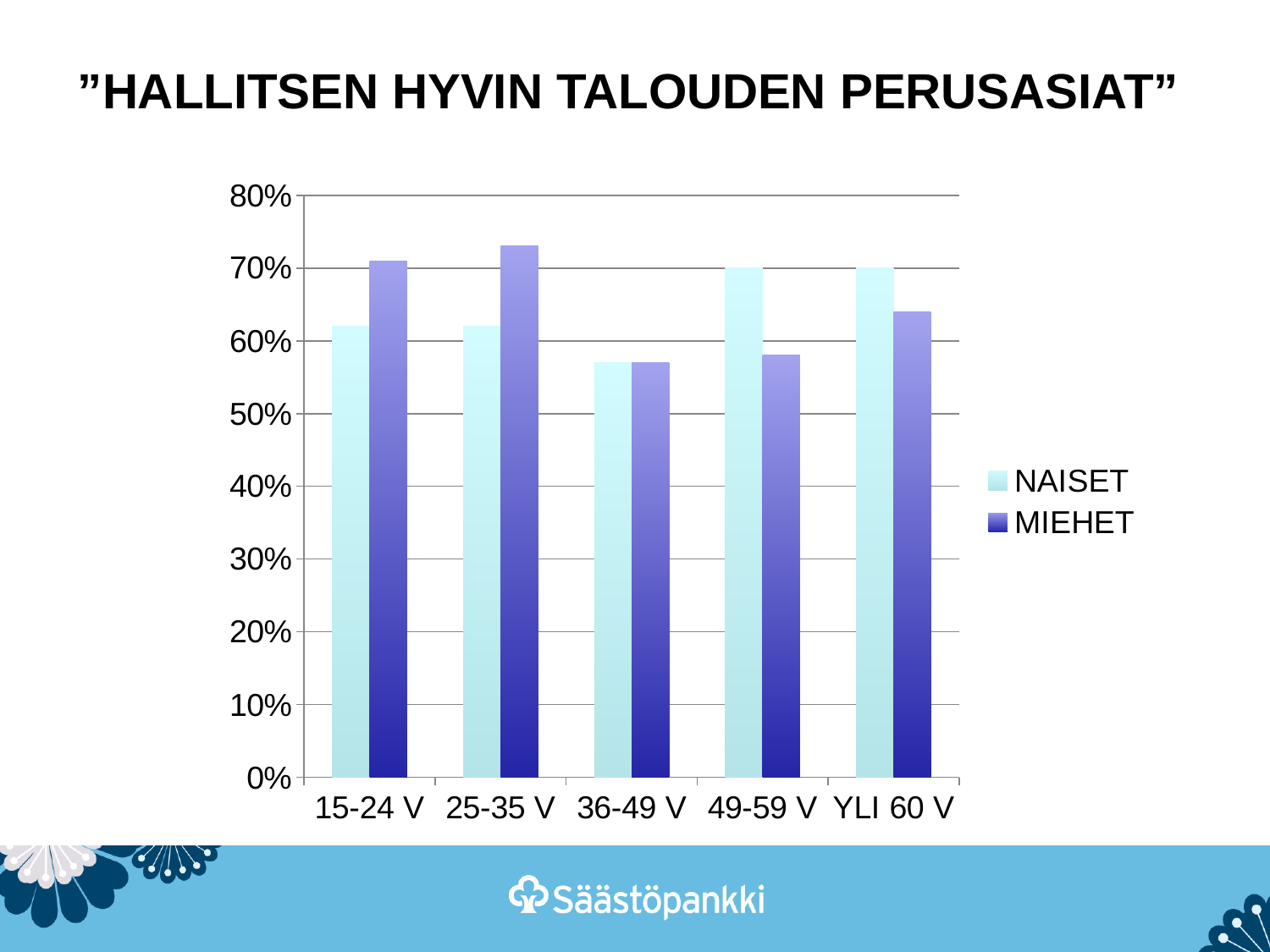
What kind of chart is shown on the slide? bar chart What is the title of the chart? "HALLITSEN HYVIN TALOUDEN PERUSASIAT" Is the NAISET value for 15-24 V greater or less than 60%? greater Which series is shown in dark blue? MIEHET Which age group has the lowest NAISET value? 36-49 V For 15-24 V, which is larger, NAISET or MIEHET? MIEHET How many age groups are shown on the x axis? 5 Is the NAISET value for 36-49 V greater or less than 60%? less Is the MIEHET value for 25-35 V greater or less than 70%? greater For 49-59 V, which is larger, NAISET or MIEHET? NAISET How many series does the legend list? 2